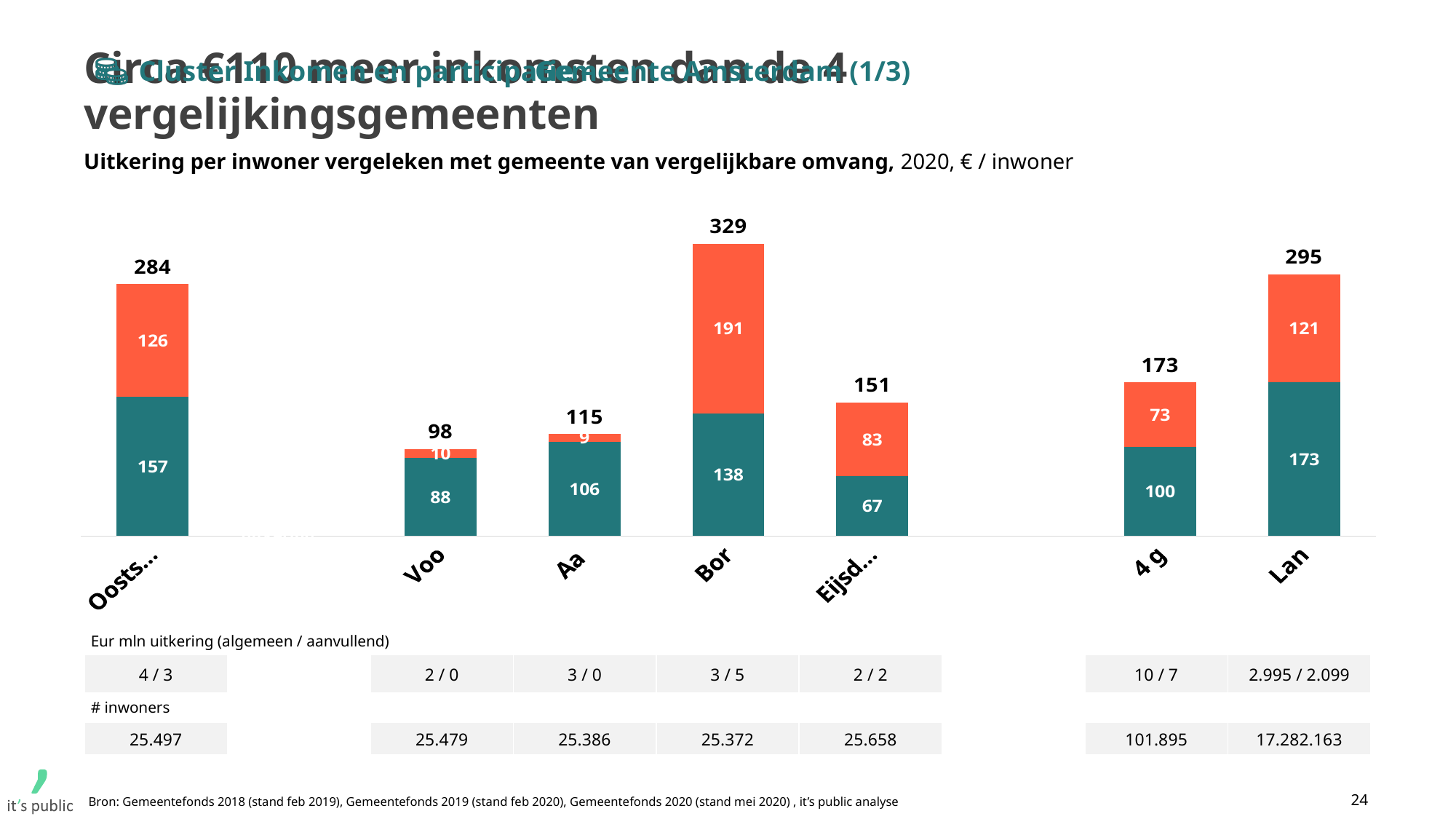
Which category has the lowest total value? Voo What is the value of the lower (dark teal) segment of the bar for Bor? 138 What is the value of the lower segment of the bar for 4 g? 100 What is the total value shown above the bar for Aa? 115 Which category has the highest total value? Bor What is the total value shown above the bar for Bor? 329 What kind of chart is shown on the slide? stacked bar chart What unit is stated in the chart subtitle for the values? € / inwoner How many bars (categories) are plotted in the chart? 7 What is the difference between the total for Bor and the total for Voo? 231 What is the value of the upper (orange) segment of the bar for Lan? 121 Which has a larger total value, Lan or 4 g? Lan